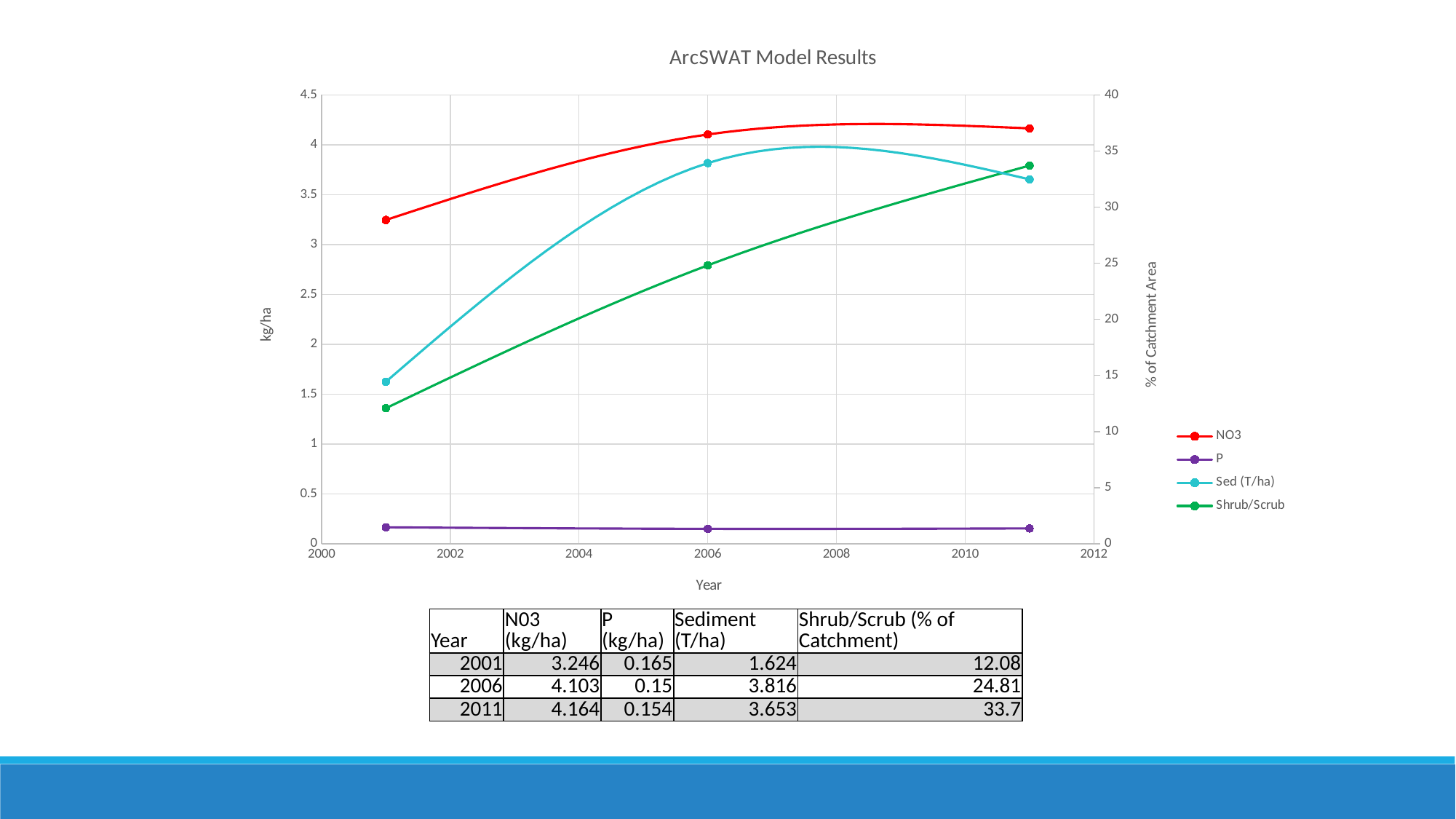
What is the Shrub/Scrub value for 2011? 33.7 What is the NO3 value for 2006? 4.103 How many series does the chart legend list? 4 What is the Sediment (T/ha) value for 2001? 1.624 Which is larger in 2011, the NO3 value or the Sediment (T/ha) value? NO3 What is the difference between the NO3 values for 2011 and 2001? 0.918 In which year is the Sediment (T/ha) series highest? 2006 What kind of chart is shown on the slide? line chart How many data points are plotted for the NO3 series? 3 What is the title of the chart? ArcSWAT Model Results In which year is the NO3 series lowest? 2001 Does the Shrub/Scrub series rise or fall from 2001 to 2011? rise